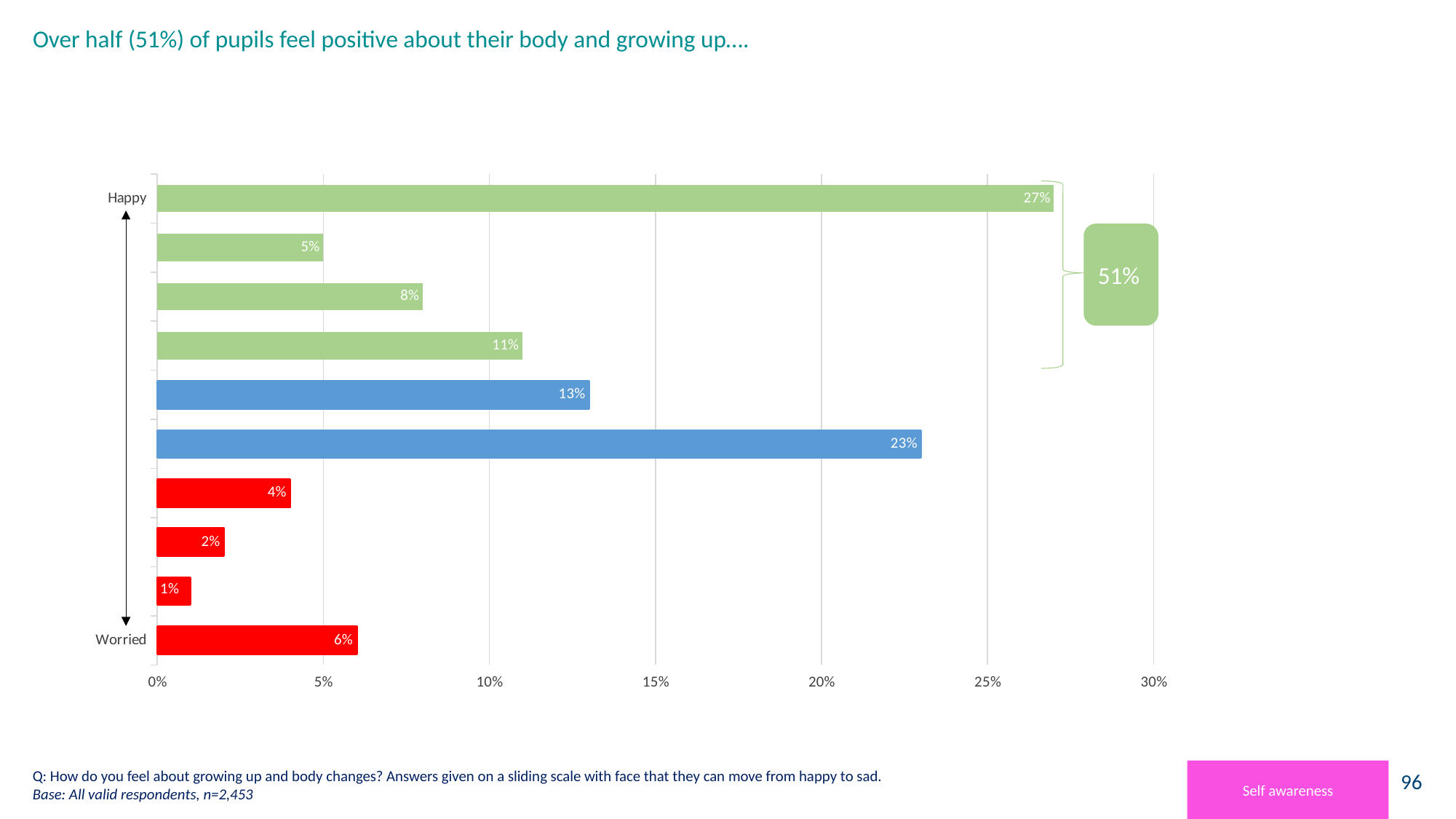
Is the value for Worried greater or less than 10%? less What is the highest value shown on the x axis? 30% Which is larger, the Happy bar or the Worried bar? Happy How many bars are plotted in the chart? 10 What is the difference between the Happy bar and the Worried bar? 21% What is the smallest value shown on any bar? 1% Which bar has the highest value? Happy What percentage is shown in the green callout box next to the bracket? 51% What is the value for the Happy bar? 27% What kind of chart is shown on the slide? bar chart What is the value for the Worried bar? 6% Is the value for Happy greater or less than 25%? greater